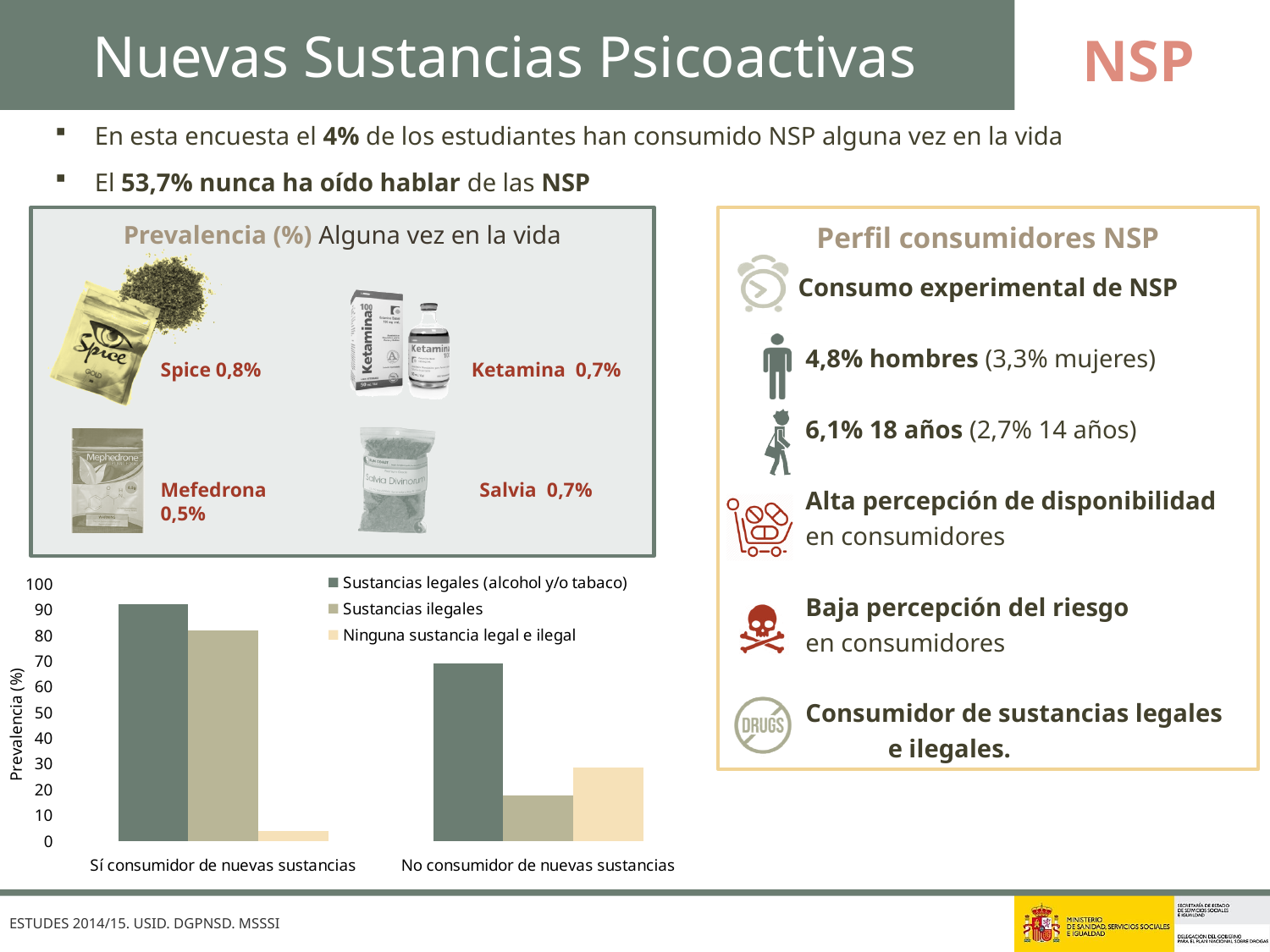
In the bar chart, is the value for 'Sustancias ilegales' among 'Sí consumidor de nuevas sustancias' greater or less than 70? greater In the bar chart, is the value for 'Sustancias ilegales' among 'No consumidor de nuevas sustancias' greater or less than 30? less In the bar chart, is the value for 'Ninguna sustancia legal e ilegal' among 'Sí consumidor de nuevas sustancias' greater or less than 10? less In the bar chart, which category has the larger value for 'Ninguna sustancia legal e ilegal': 'Sí consumidor de nuevas sustancias' or 'No consumidor de nuevas sustancias'? No consumidor de nuevas sustancias In the bar chart, which series has the lowest value for 'No consumidor de nuevas sustancias'? Sustancias ilegales What is the label of the y axis of the bar chart? Prevalencia (%) How many series does the legend of the bar chart list? 3 What kind of chart is shown at the bottom left of the slide? bar chart How many categories are shown on the x axis of the bar chart? 2 In the bar chart, which series has the highest value for 'Sí consumidor de nuevas sustancias'? Sustancias legales (alcohol y/o tabaco)